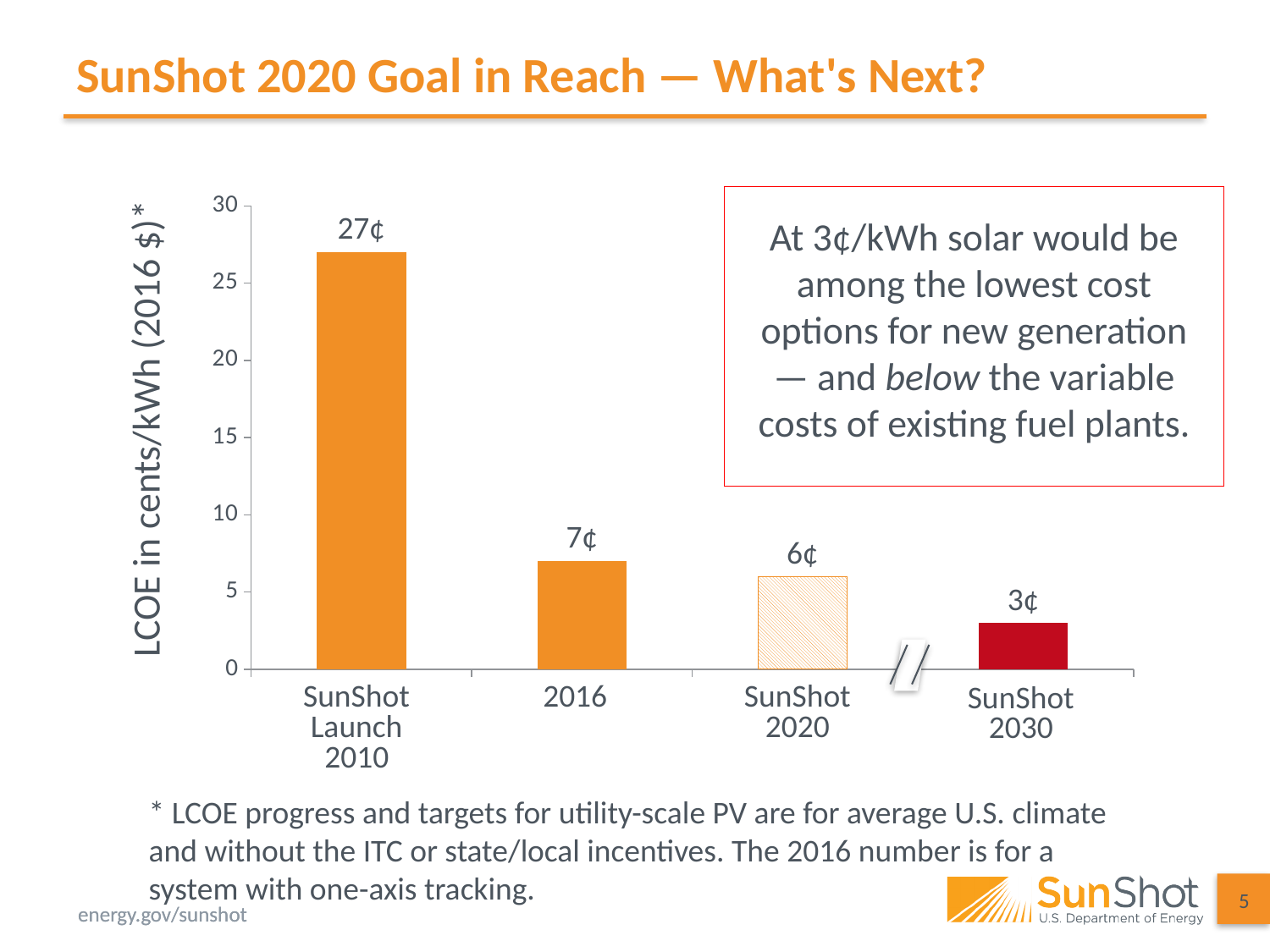
What kind of chart is shown on the slide? Bar chart Which category has the highest LCOE value? SunShot Launch 2010 What is the LCOE value shown for SunShot 2030? 3¢ What is the LCOE value shown for 2016? 7¢ Which category has the lowest LCOE value? SunShot 2030 What is the difference between the LCOE for SunShot Launch 2010 and the LCOE for 2016? 20¢ How many categories are shown on the x axis of the chart? 4 What is the difference between the LCOE for SunShot 2020 and the LCOE for SunShot 2030? 3¢ What is the LCOE value shown for SunShot 2020? 6¢ What is the LCOE value shown for SunShot Launch 2010? 27¢ Which is larger, the LCOE for 2016 or the LCOE for SunShot 2020? 2016 Do the LCOE values rise or fall from left to right along the x axis? Fall